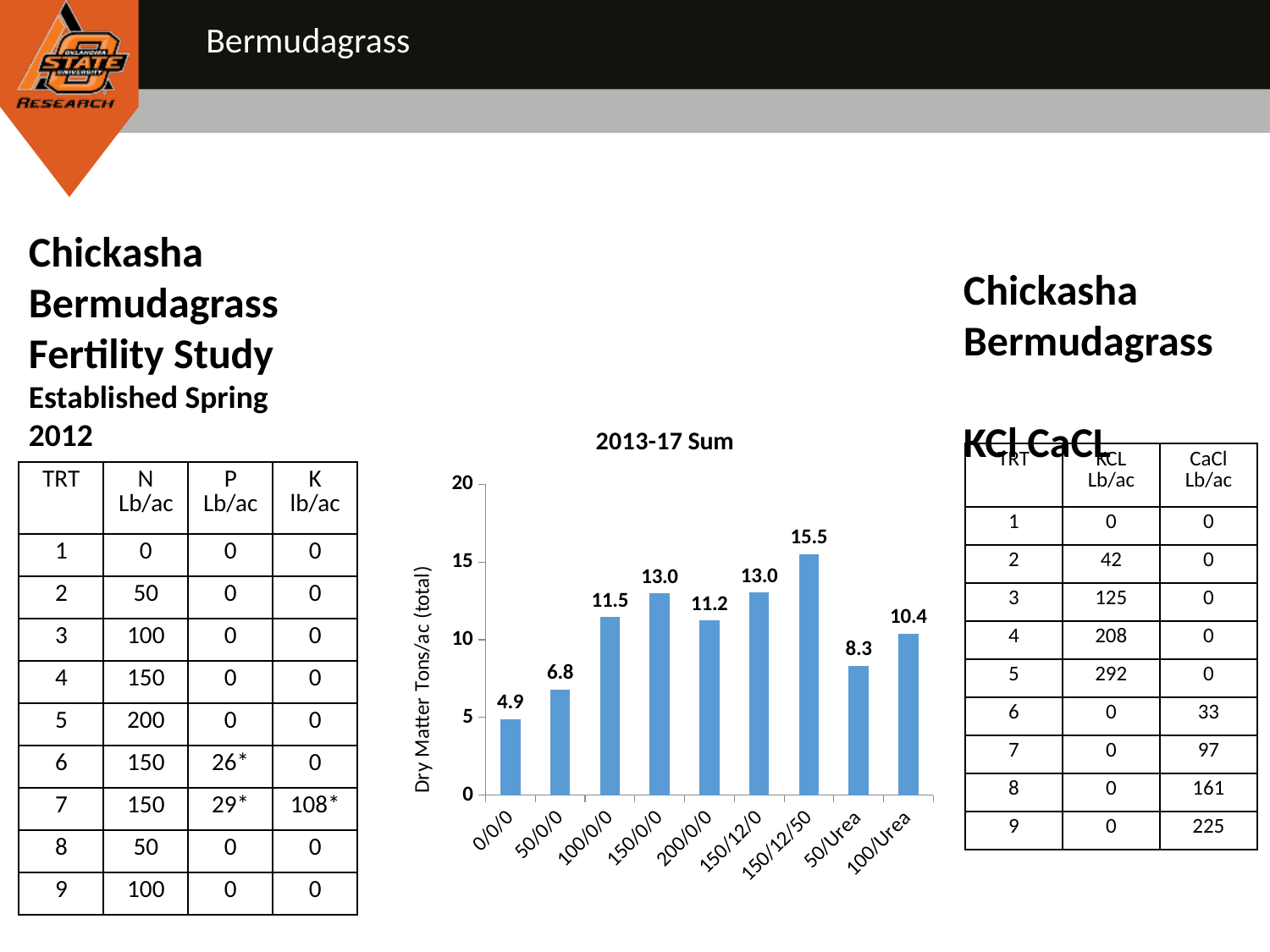
What kind of chart is the 2013-17 Sum chart? bar chart Which treatment has the highest value in the 2013-17 Sum chart? 150/12/50 Which has a larger value in the 2013-17 Sum chart, 100/0/0 or 200/0/0? 100/0/0 Is the value for 100/Urea greater or less than 10 in the 2013-17 Sum chart? greater What is the difference between the values for 150/12/50 and 0/0/0 in the 2013-17 Sum chart? 10.6 What is the value for the 150/12/50 treatment in the 2013-17 Sum chart? 15.5 What is the value for the 0/0/0 treatment in the 2013-17 Sum chart? 4.9 Which treatment has the lowest value in the 2013-17 Sum chart? 0/0/0 What is the value for the 50/Urea treatment in the 2013-17 Sum chart? 8.3 What is the y-axis label of the 2013-17 Sum chart? Dry Matter Tons/ac (total) What is the difference between the values for 50/Urea and 100/Urea in the 2013-17 Sum chart? 2.1 How many treatments are plotted in the 2013-17 Sum chart? 9